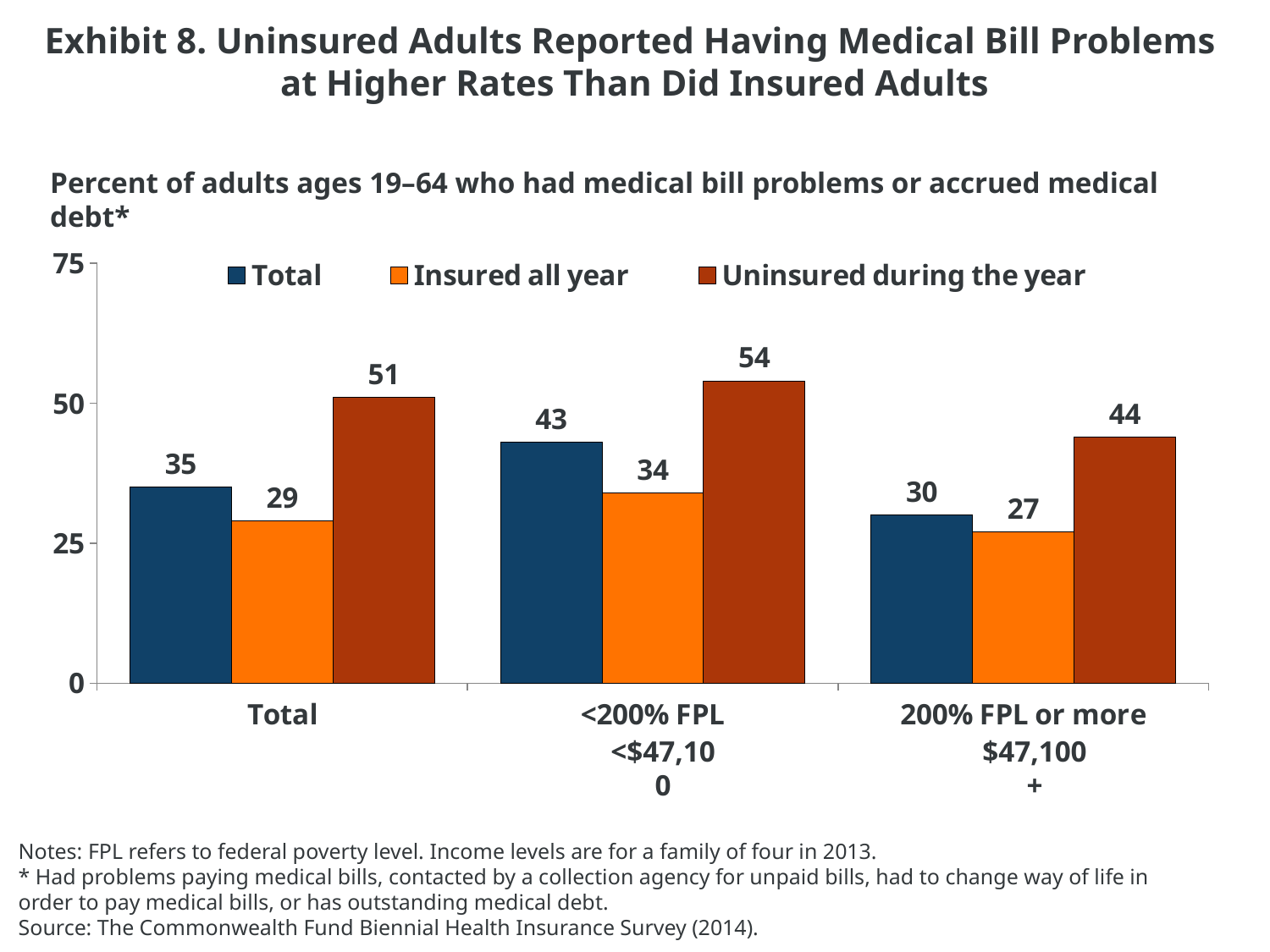
Which category has the highest value for Uninsured during the year? <200% FPL What is the source cited for the chart? The Commonwealth Fund Biennial Health Insurance Survey (2014) What is the value for Uninsured during the year in the Total category? 51 What is the difference between Uninsured during the year and Insured all year in the Total category? 22 Which is larger in the 200% FPL or more category: Uninsured during the year or Total? Uninsured during the year Is the value for Uninsured during the year in the <200% FPL category greater or less than 50? greater What is the value for Insured all year in the <200% FPL category? 34 How many series does the legend list? 3 What is the value for Total in the 200% FPL or more category? 30 How many categories are shown on the x axis? 3 What kind of chart is shown on the slide? Bar chart Which category has the lowest value for Insured all year? 200% FPL or more